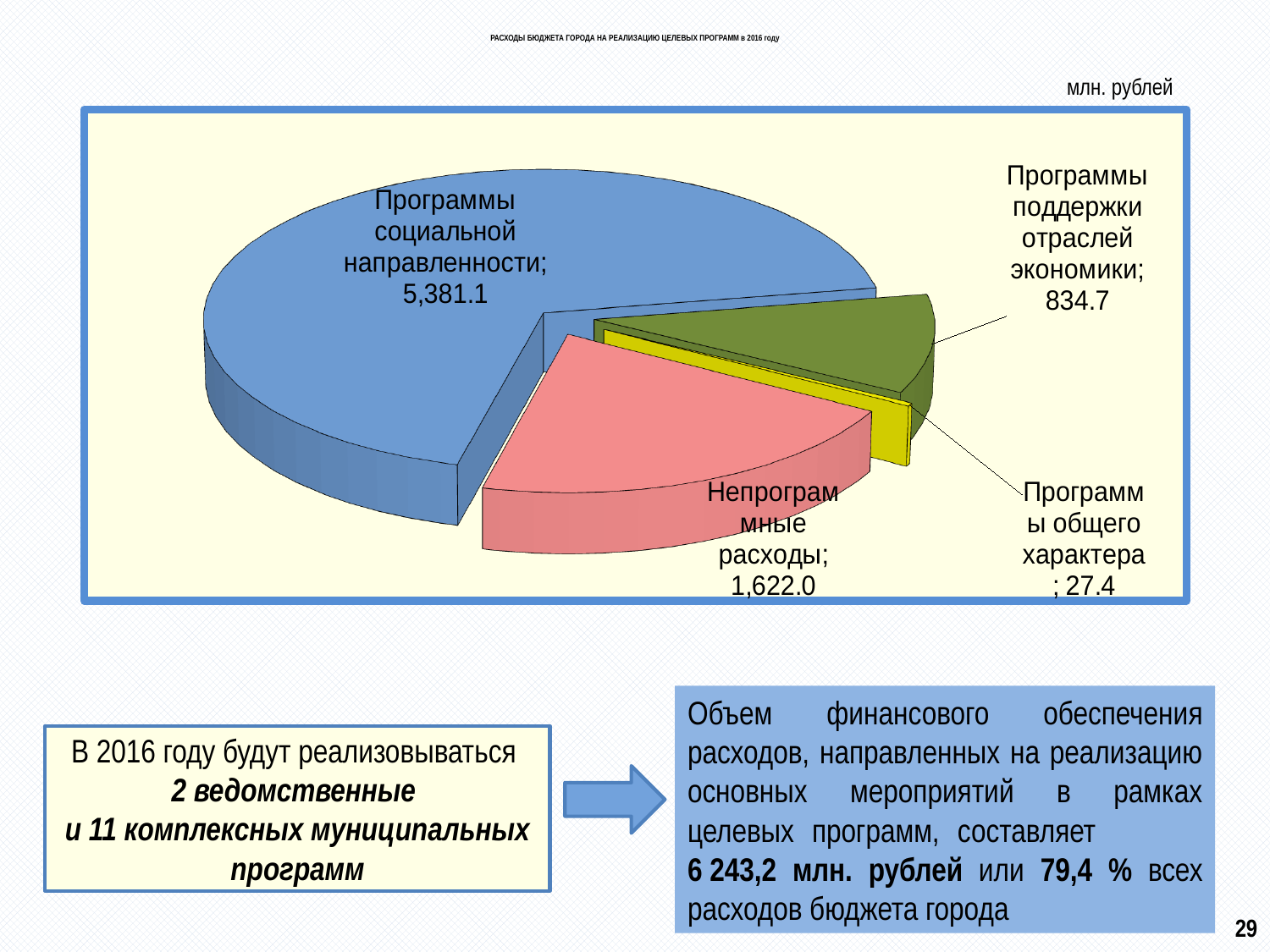
What is the difference between Программы социальной направленности and Непрограммные расходы? 3,759.1 Which is larger: Непрограммные расходы or Программы поддержки отраслей экономики? Непрограммные расходы What is the value for Программы социальной направленности? 5,381.1 What is the value for Программы поддержки отраслей экономики? 834.7 In what units are the values in the pie chart expressed? млн. рублей What is the value for Программы общего характера? 27.4 What type of chart is shown on the slide? Pie chart Which category has the largest slice of the pie? Программы социальной направленности How many slices does the pie chart have? 4 What is the total of all four slices in the pie chart? 7,865.2 What is the value for Непрограммные расходы? 1,622.0 Which category has the smallest slice of the pie? Программы общего характера